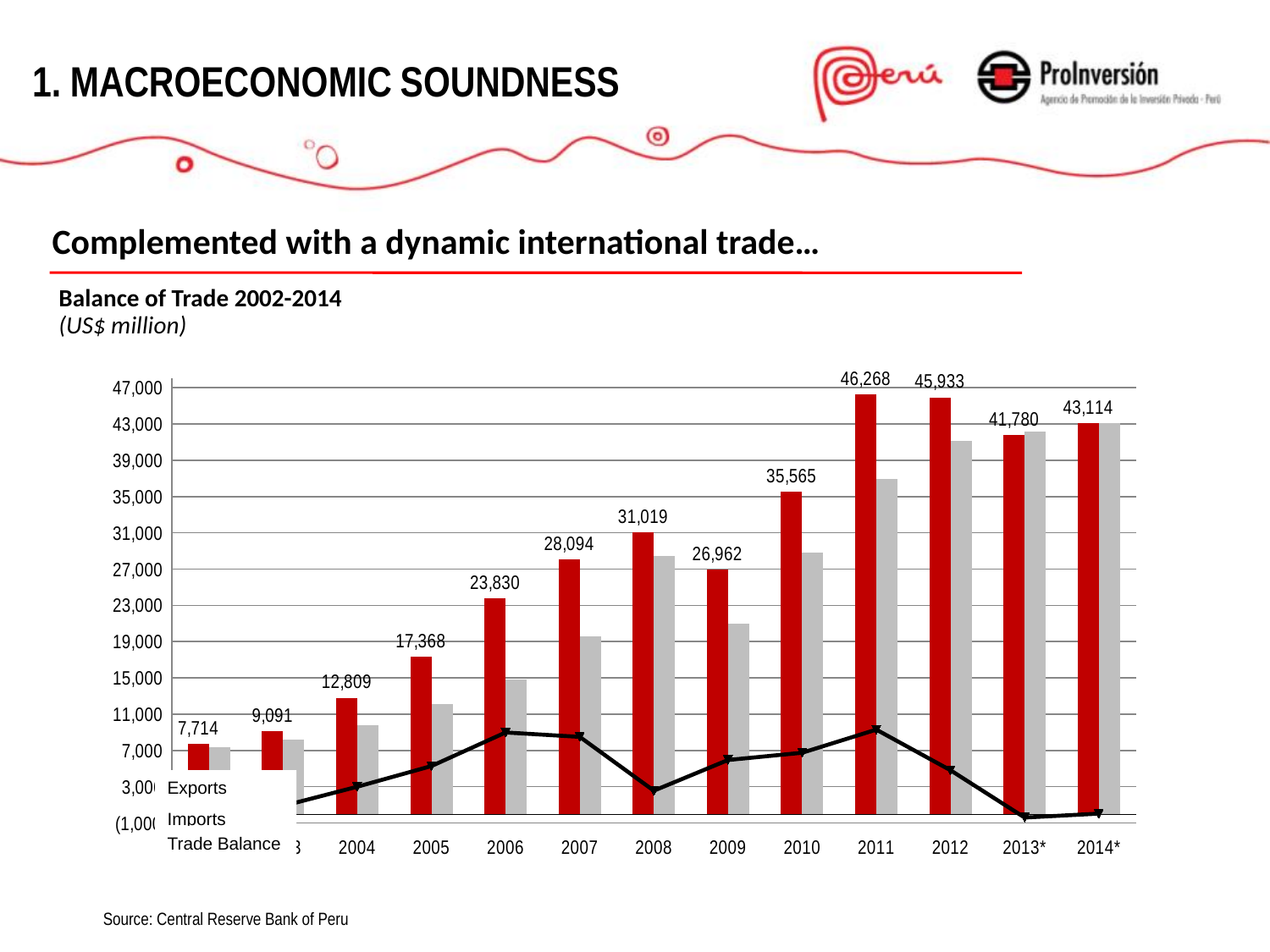
Is the value of Imports in 2010 greater or less than 31,000? less What is the value of Exports in 2010? 35,565 In which year are Exports highest? 2011 How many series does the legend list? 3 What is the difference between Exports in 2011 and Exports in 2012? 335 In what unit are the values on the chart expressed? US$ million Do Exports rise or fall from 2004 to 2008? rise What is the value of Exports in 2014*? 43,114 Which year has higher Exports, 2008 or 2009? 2008 By how much do Exports in 2014* exceed Exports in 2013*? 1,334 In 2011, which is larger, Exports or Imports? Exports What is the value of Exports in 2006? 23,830